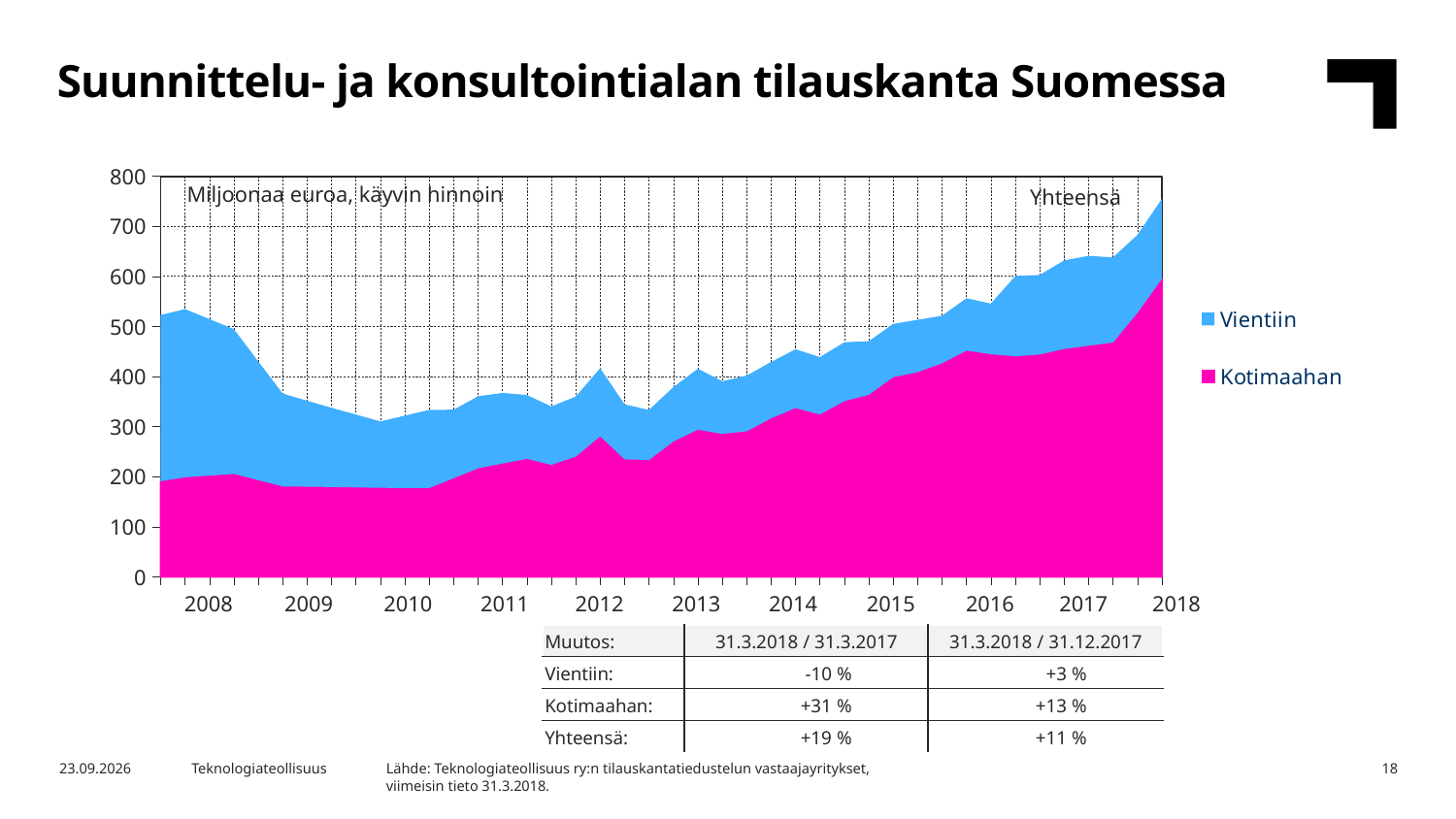
How many series does the chart legend list? 2 Is the value for Kotimaahan around 2010 greater or less than 200? less Does the Kotimaahan series rise or fall overall from 2010 to 2018? rise Is the value for Kotimaahan around 2017 greater or less than 400? greater Is the total (Yhteensä) at the 2018 end of the chart greater or less than 700? greater What are the two series named in the chart legend? Vientiin and Kotimaahan What type of chart is shown on the slide? Stacked area chart At the 2018 end of the chart, which series is larger, Vientiin or Kotimaahan? Kotimaahan At the start of the chart in 2008, which series is larger, Vientiin or Kotimaahan? Vientiin What is the title of the slide containing the chart? Suunnittelu- ja konsultointialan tilauskanta Suomessa